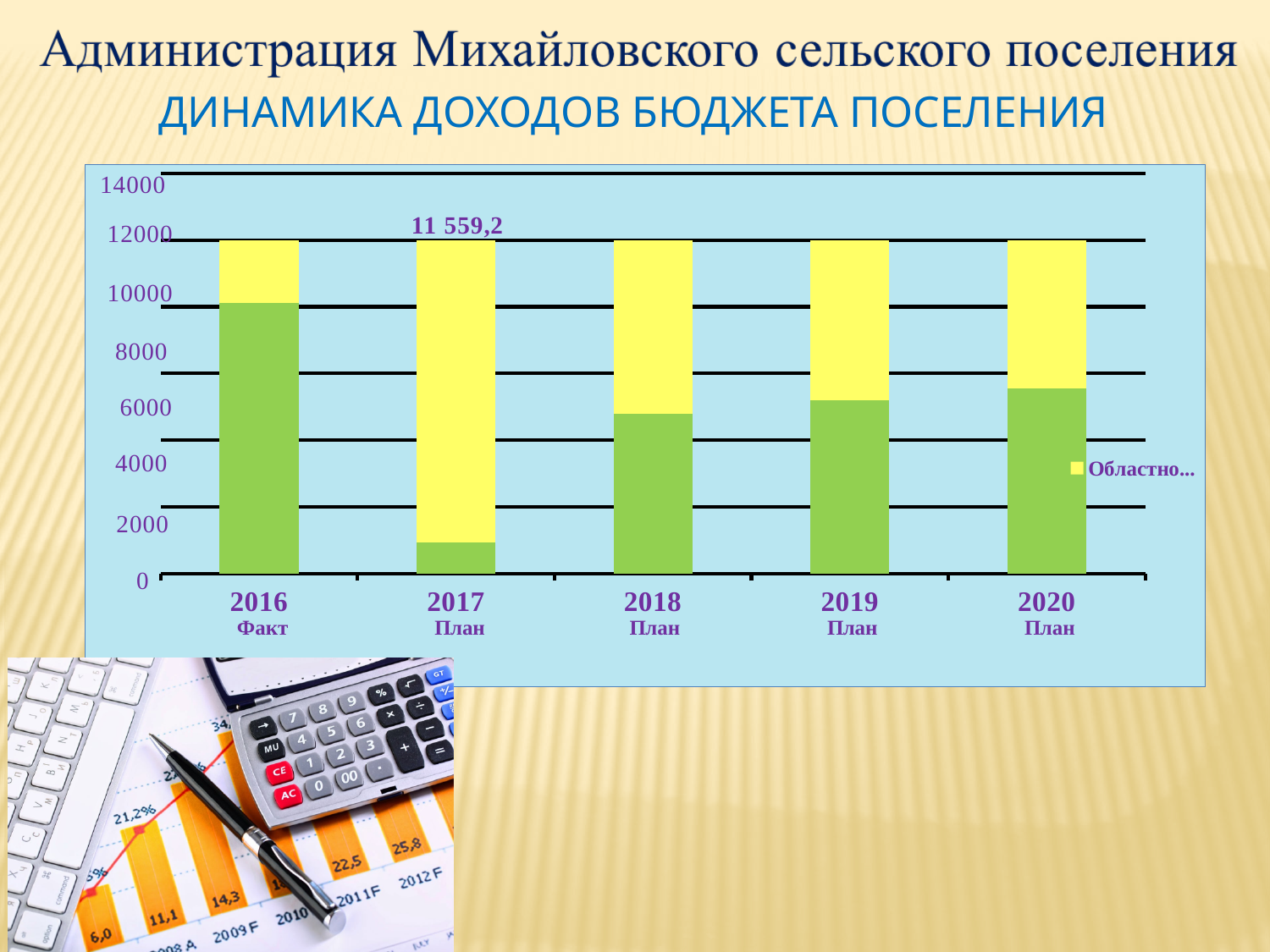
What value is printed as the data label above the 2017 bar? 11 559,2 Which has the larger green segment, 2016 or 2020? 2016 Does the green segment rise or fall from 2017 to 2020? Rises Is the green segment for 2016 greater or less than 8000? greater Is the green segment for 2020 greater or less than 8000? less Which year on the x axis is labelled "Факт" rather than "План"? 2016 Is the green segment for 2017 greater or less than 2000? less How many years (categories) are shown on the x axis of the chart? 5 Which year has the smallest green segment in the chart? 2017 Which year has the largest green segment in the chart? 2016 What kind of chart is shown on the slide? Stacked bar chart What is the title of the chart on the slide? ДИНАМИКА ДОХОДОВ БЮДЖЕТА ПОСЕЛЕНИЯ